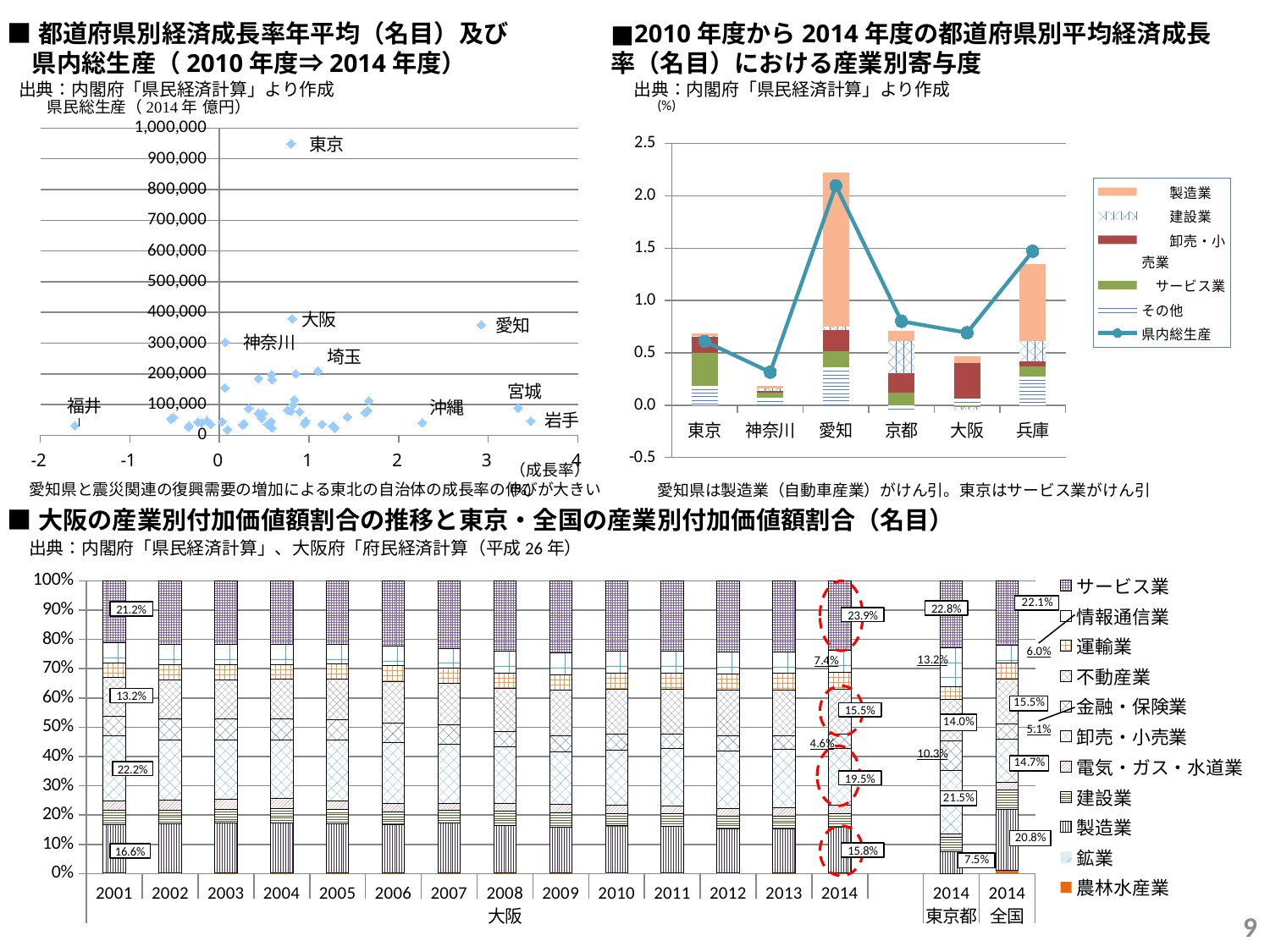
In the top-right chart (産業別寄与度), how many prefectures are shown on the x axis? 6 In the top-right chart (産業別寄与度), how many entries does the legend list? 6 In the top-right chart (産業別寄与度), is the 県内総生産 line value for 愛知 greater or less than 2.0? greater In the bottom chart (大阪の産業別付加価値額割合の推移), what is the share of サービス業 for 東京都 in 2014? 22.8% In the bottom chart (大阪の産業別付加価値額割合の推移), what is the share of 製造業 for 大阪 in 2014? 15.8% In the bottom chart (大阪の産業別付加価値額割合の推移), what is the difference between the 製造業 share of 大阪 in 2014 (15.8%) and that of 東京都 in 2014 (7.5%)? 8.3 percentage points In the top-left chart (都道府県別経済成長率年平均及び県内総生産), is the growth rate (成長率) for 福井 greater or less than -1? less In the bottom chart (大阪の産業別付加価値額割合の推移), how many industries does the legend list? 11 In the top-right chart (産業別寄与度), which prefecture has the highest 県内総生産 value on the line? 愛知 In the top-left chart (都道府県別経済成長率年平均及び県内総生産), what kind of chart is it? scatter chart In the top-left chart (都道府県別経済成長率年平均及び県内総生産), which labeled prefecture has the highest 県内総生産? 東京 In the top-left chart (都道府県別経済成長率年平均及び県内総生産), is the 県内総生産 value for 東京 greater or less than 900,000? greater